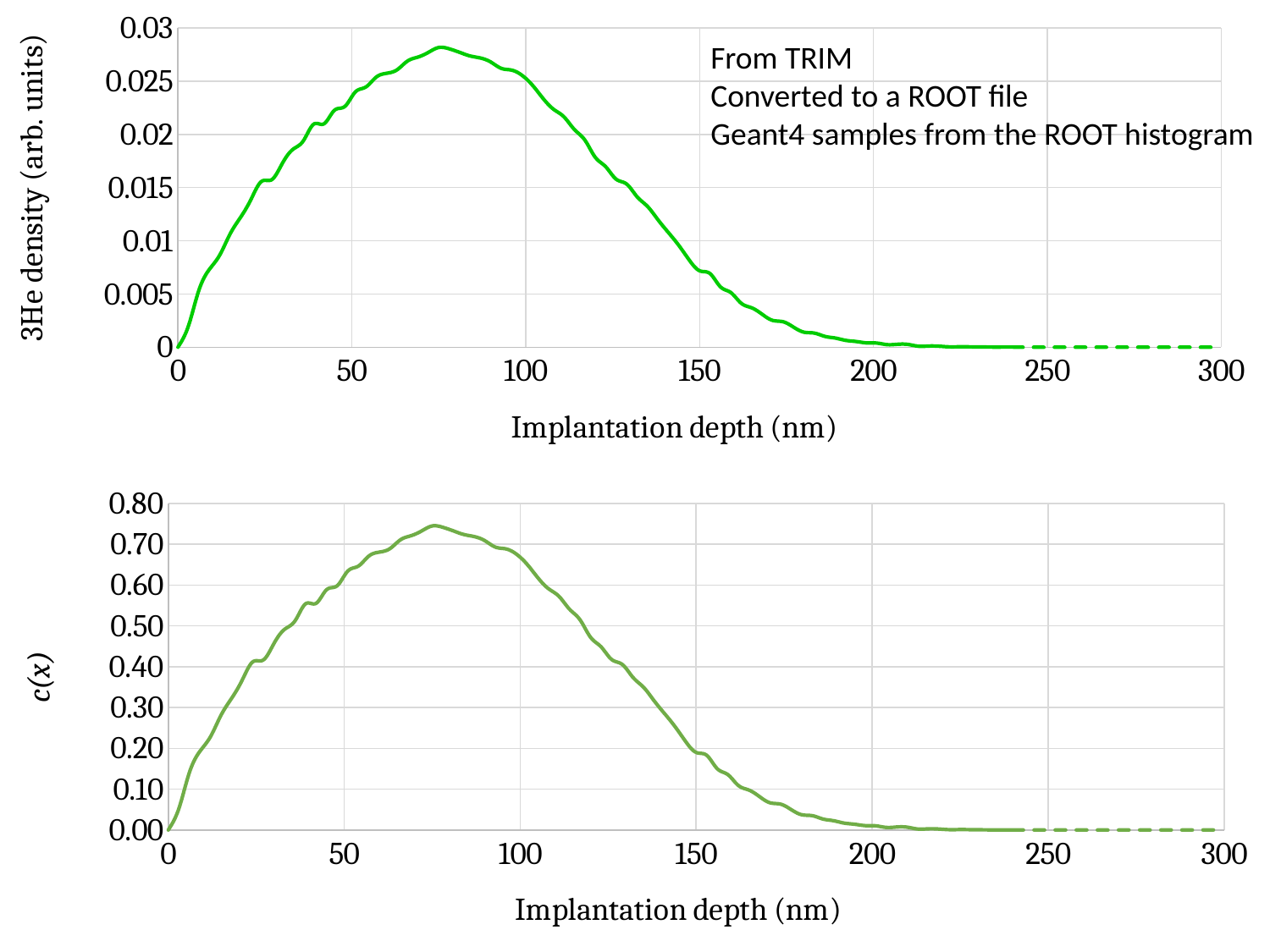
What kind of chart is the top chart on the slide? line chart In the top chart, does the 3He density rise or fall as implantation depth increases from 100 nm to 200 nm? fall In the bottom chart, does c(x) rise or fall as implantation depth increases from 0 nm to 50 nm? rise What is the y-axis label of the bottom chart? c(x) What is the x-axis label of the top chart? Implantation depth (nm) In the top chart, is the 3He density at an implantation depth of 150 nm greater or less than 0.01? less In the bottom chart, is c(x) at an implantation depth of 150 nm greater or less than 0.30? less In the bottom chart, is the peak value of c(x) greater or less than 0.80? less How many charts are shown on the slide? 2